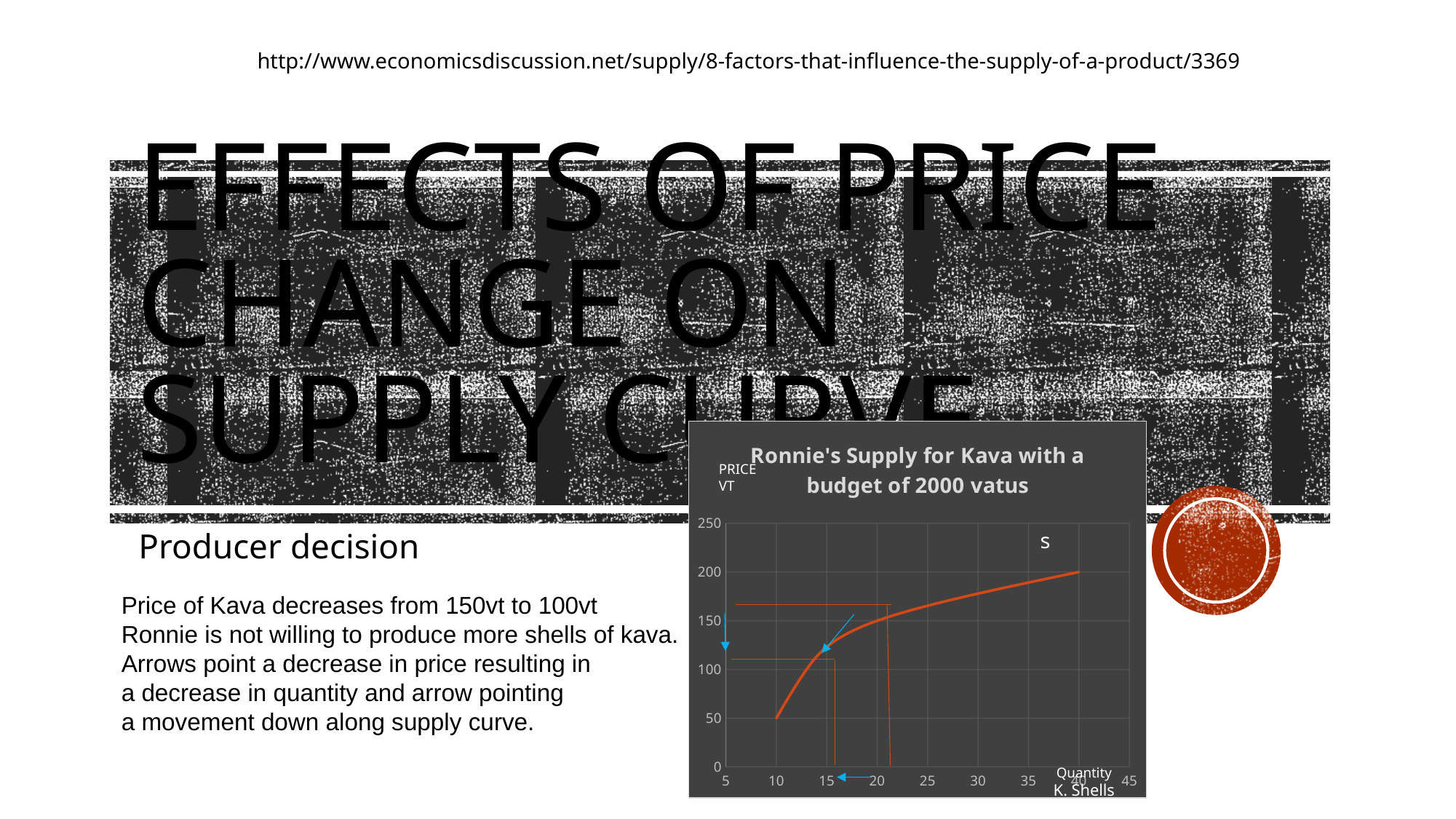
Is the price on the supply curve at a quantity of 30 greater or less than 150? greater At which quantity does the supply curve reach its highest price? 40 What kind of chart is shown on the slide? line chart What is the label on the vertical axis of the chart? PRICE VT What is the title of the chart? Ronnie's Supply for Kava with a budget of 2000 vatus Do the values on the supply curve rise or fall as quantity increases along the x axis? rise What is the highest value shown on the horizontal axis of the chart? 45 Is the price on the supply curve at a quantity of 25 greater or less than 150? greater Is the price on the supply curve at a quantity of 40 greater or less than 150? greater How many tick labels are shown on the horizontal axis of the chart? 9 What is the highest value shown on the vertical axis of the chart? 250